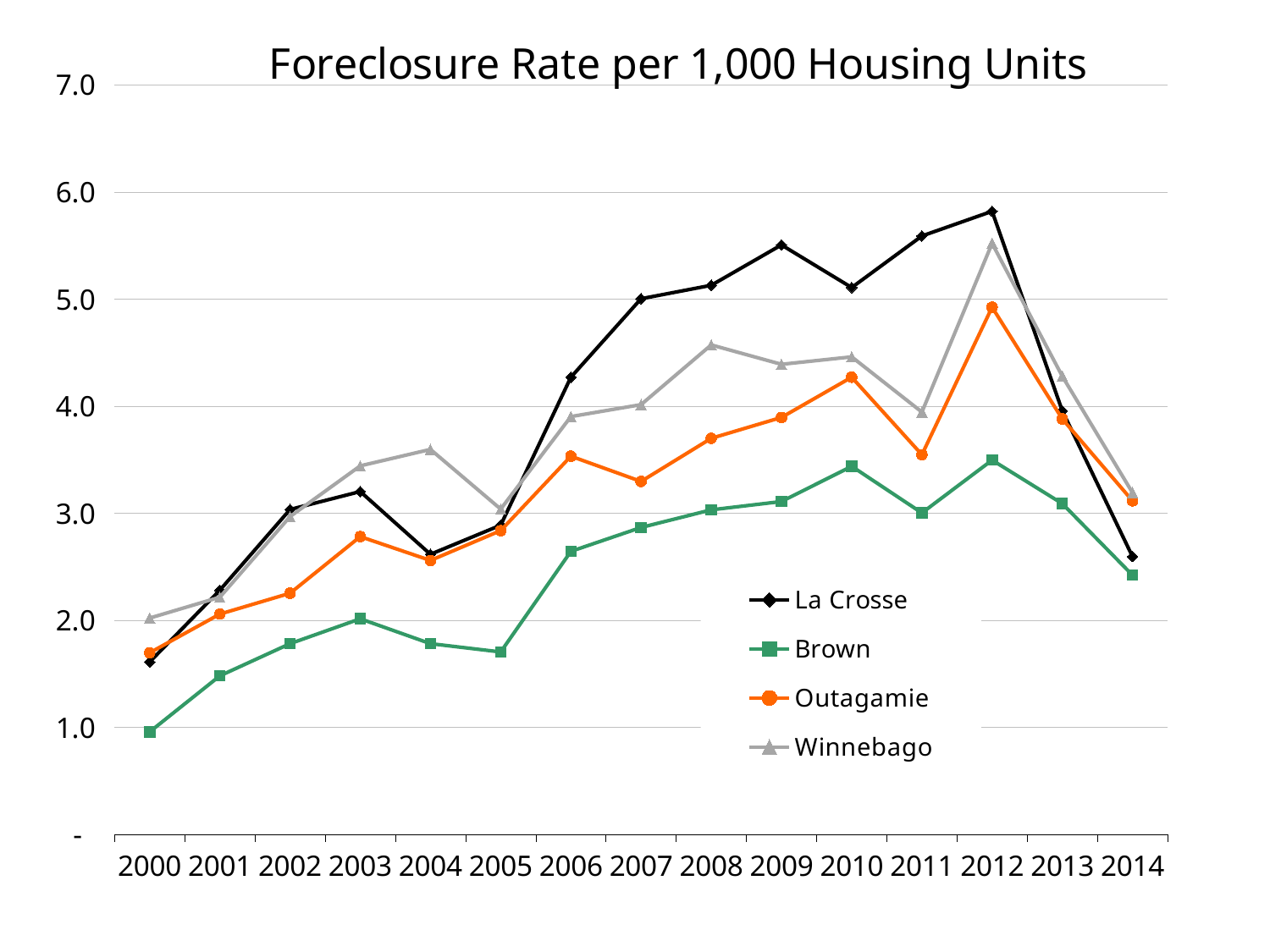
In which year does La Crosse reach its highest value? 2012 Does the La Crosse line rise or fall from 2012 to 2014? fall Is the value for Brown in 2014 greater or less than 3.0? less How many series does the legend list? 4 Which series has the highest value in 2012? La Crosse Is the value for Winnebago in 2005 greater or less than 4.0? less In 2004, which is higher: Winnebago or La Crosse? Winnebago Is the value for La Crosse in 2012 greater or less than 5.0? greater What is the title of the chart? Foreclosure Rate per 1,000 Housing Units What kind of chart is shown on the slide? line chart How many years are shown along the x axis? 15 Which series has the lowest value in 2000? Brown